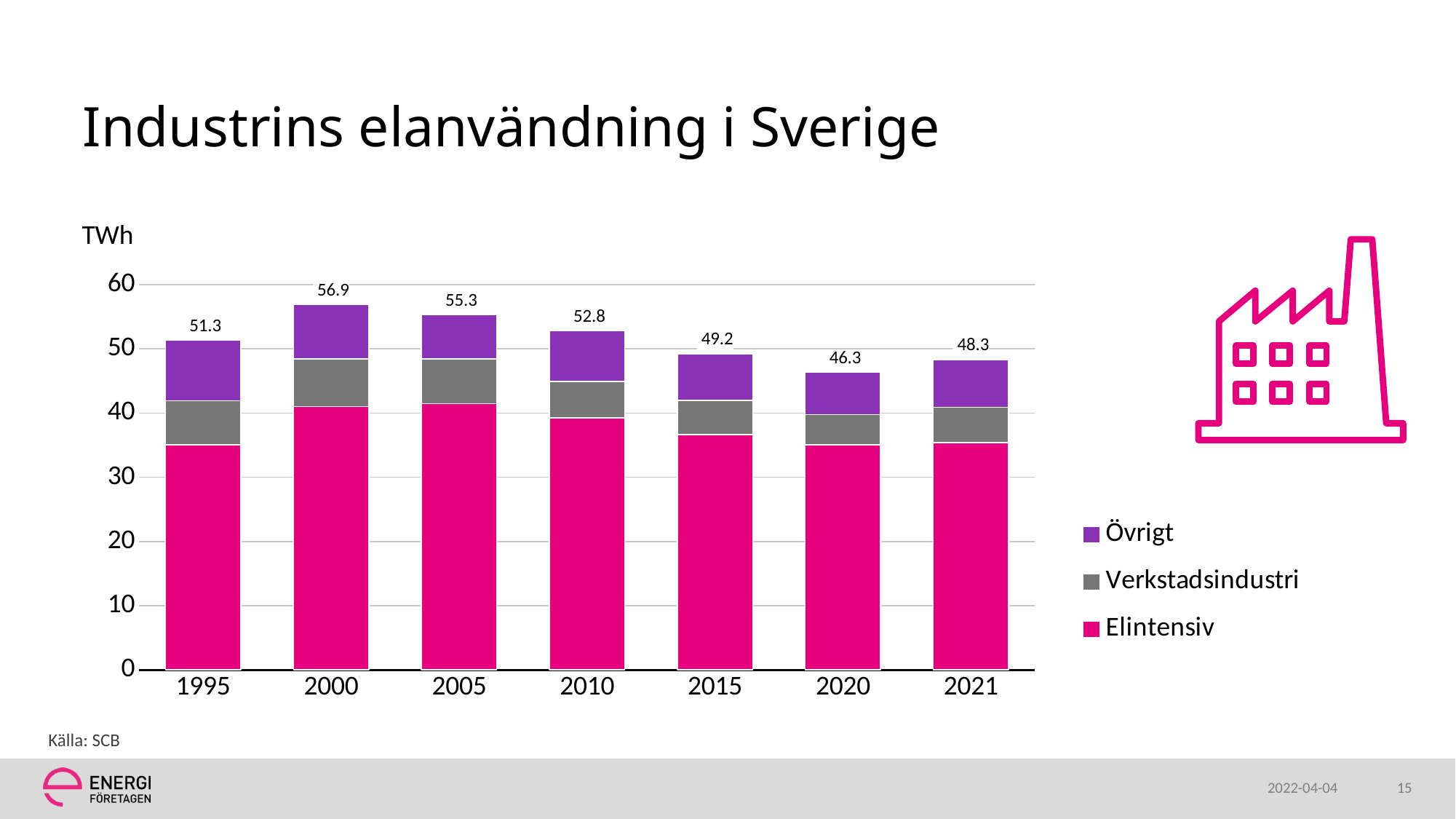
How many series does the legend list? 3 Which year has the highest total? 2000 What unit is shown on the y axis? TWh Which total is larger, 2015 or 2021? 2015 What kind of chart is shown? Stacked bar chart What is the total value for 2021? 48.3 Do the totals rise or fall from 2000 to 2020? Fall What is the difference between the totals for 2000 and 2020? 10.6 Is the Elintensiv value for 2015 greater or less than 40? less What is the total value for 2000? 56.9 How many years are shown on the x axis? 7 Which year has the lowest total? 2020